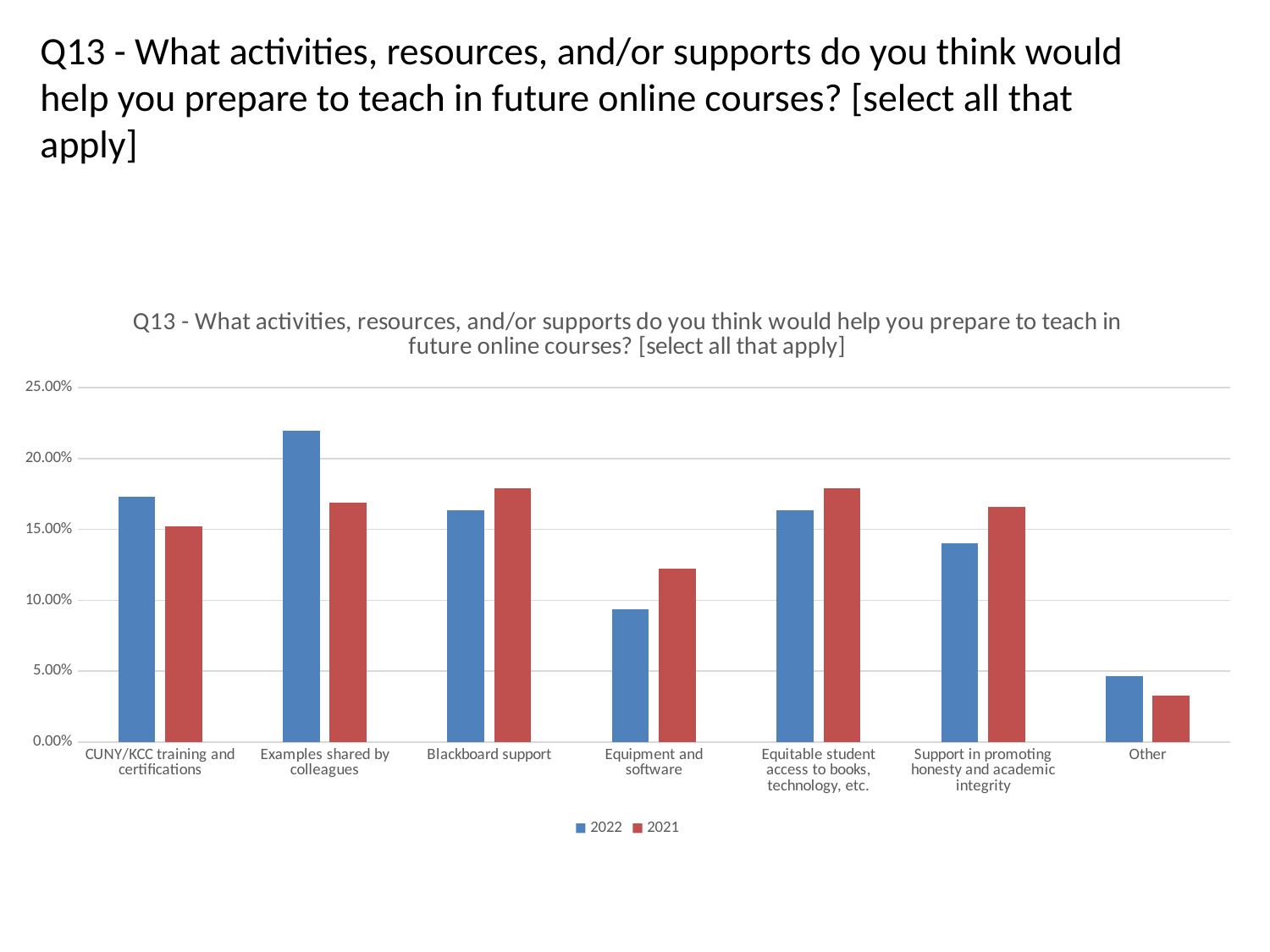
Which series is shown in blue according to the legend? 2022 Which category has the highest value for 2022? Examples shared by colleagues Is the 2022 value for Equipment and software greater or less than 10.00%? less How many categories are shown on the x axis? 7 For Equipment and software, which year has the larger value, 2022 or 2021? 2021 Which category has the lowest value for 2022? Other What kind of chart is shown on the slide? bar chart How many series does the legend list? 2 For Examples shared by colleagues, which year has the larger value, 2022 or 2021? 2022 Which category has the lowest value for 2021? Other Is the 2021 value for Blackboard support greater or less than 15.00%? greater Is the 2022 value for Examples shared by colleagues greater or less than 20.00%? greater